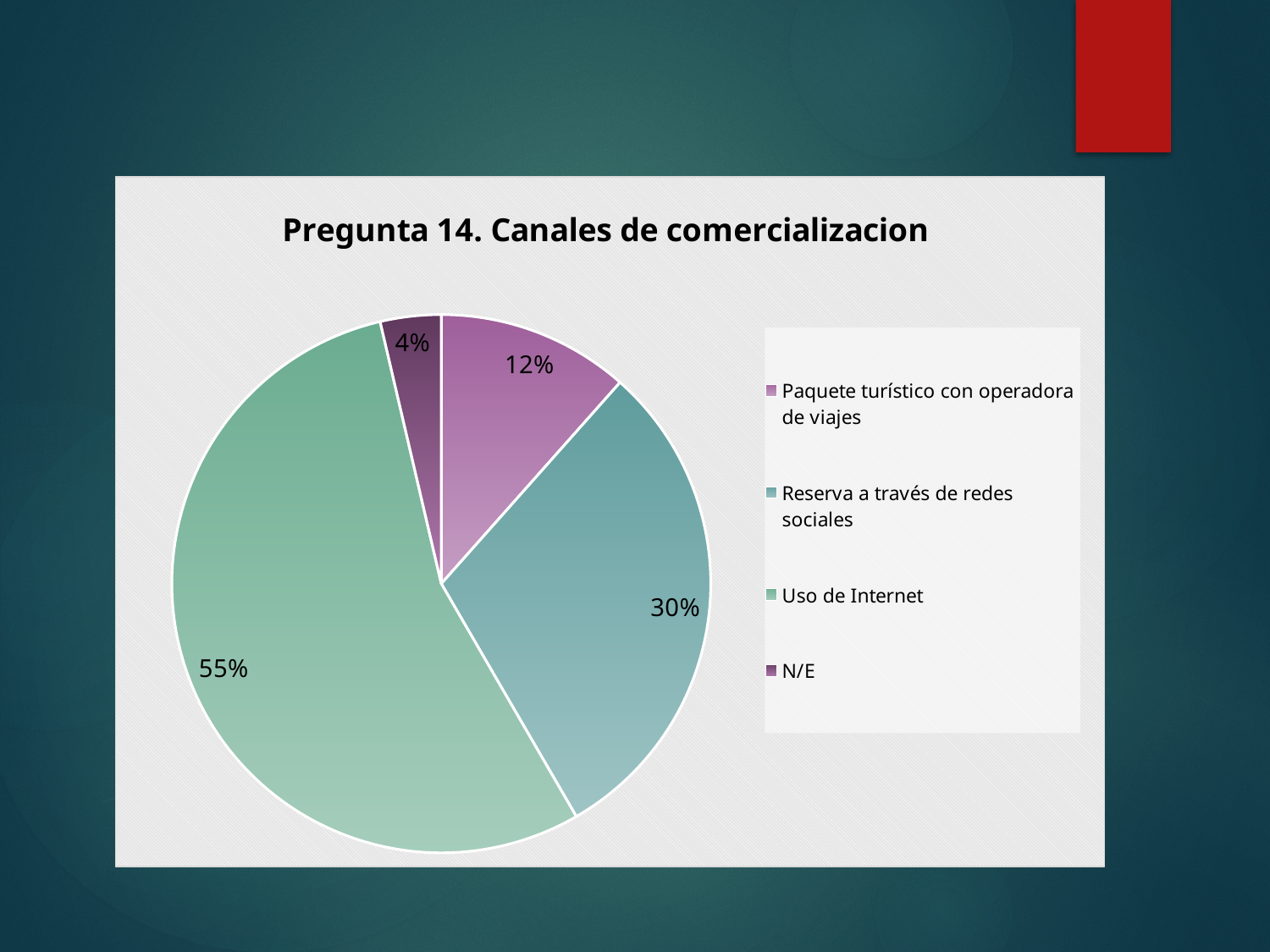
What percentage share does 'Paquete turístico con operadora de viajes' have? 12% What percentage share does 'Uso de Internet' have? 55% Which category has the largest slice of the pie? Uso de Internet What colour is the slice for 'Uso de Internet'? Green Which is larger: 'Paquete turístico con operadora de viajes' or 'Reserva a través de redes sociales'? Reserva a través de redes sociales What percentage share does 'N/E' have? 4% How many categories does the legend list? 4 What is the difference in percentage points between 'Uso de Internet' and 'Reserva a través de redes sociales'? 25 What is the title of the chart? Pregunta 14. Canales de comercializacion What type of chart is shown on the slide? Pie chart Which category has the smallest slice of the pie? N/E